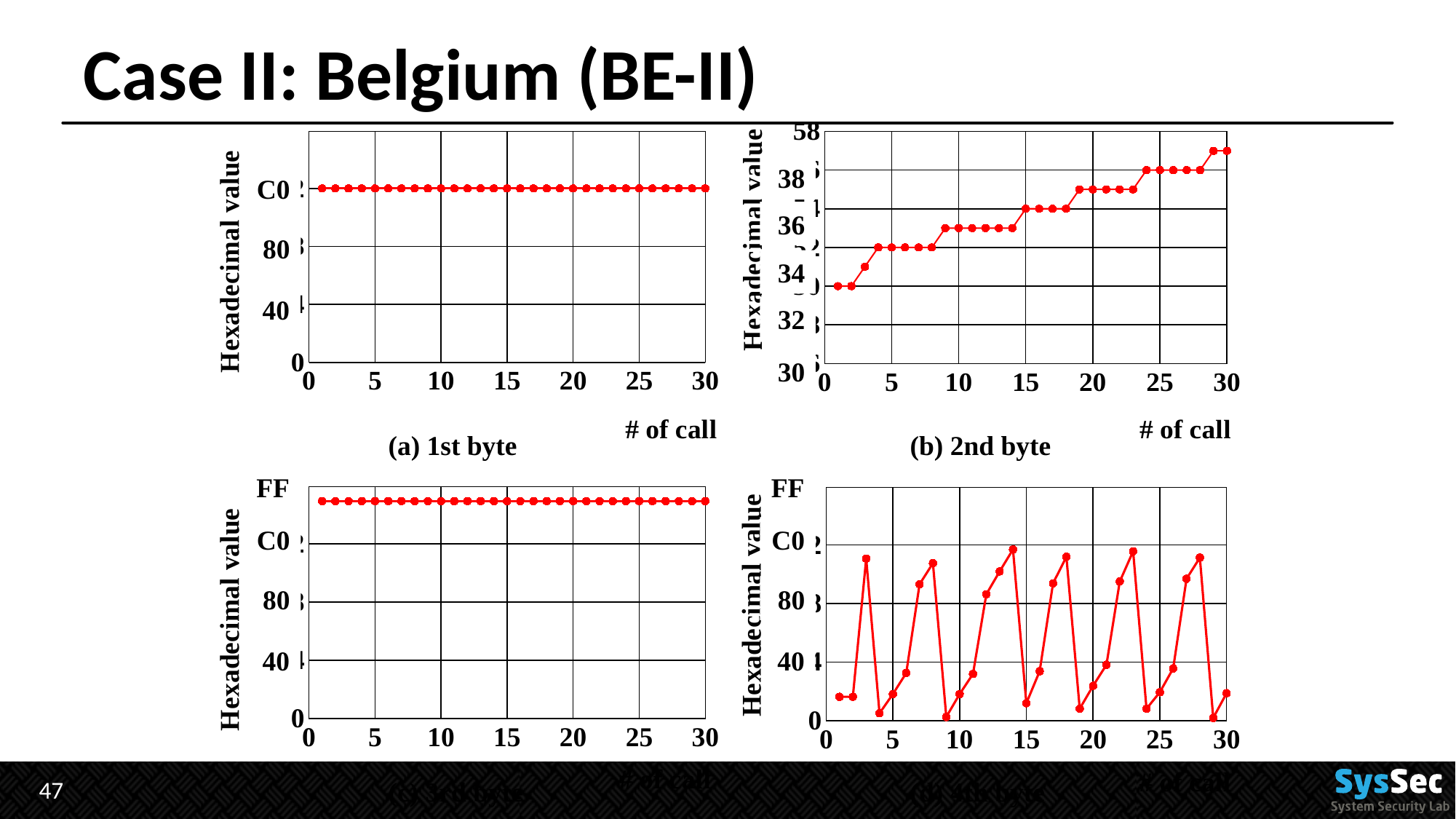
In chart (a) 1st byte, do the values rise, fall or stay flat as the number of calls increases? stay flat In chart (b) 2nd byte, is the value at call 30 greater or less than 38? greater In the bottom-right chart, is the value at call 14 greater or less than 80? greater In the bottom-left chart, is the value at call 15 greater or less than C0? greater In chart (a) 1st byte, what is the hexadecimal value at call 10? C0 In chart (b) 2nd byte, do the values rise or fall as the number of calls increases? rise What is the x-axis label of chart (a) 1st byte? # of call In the bottom-left chart, do the values rise, fall or stay flat across the calls? stay flat In the bottom-right chart, which is larger, the value at call 3 or the value at call 5? call 3 What kind of chart is chart (a) 1st byte? line chart